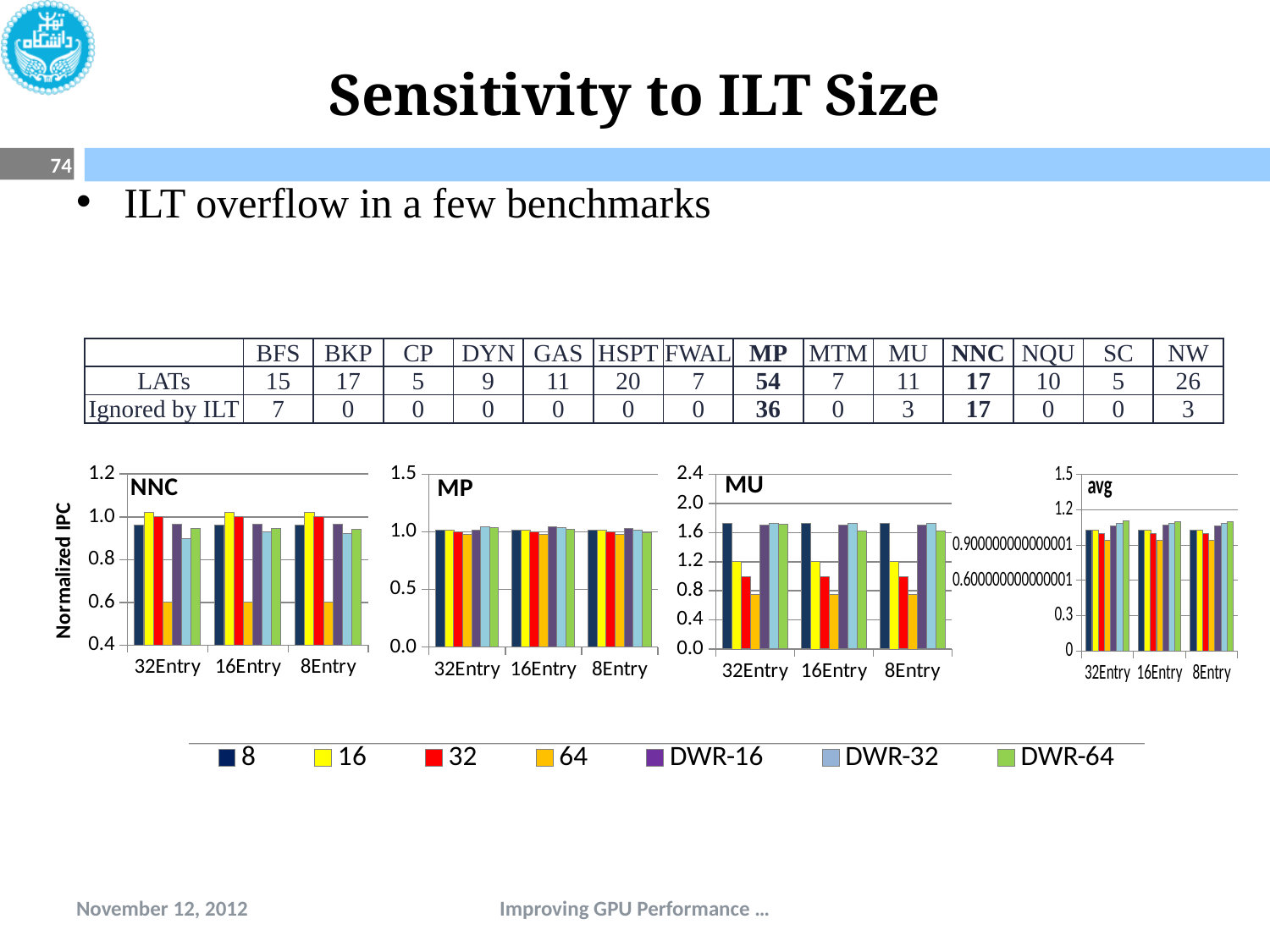
What kind of chart is the NNC chart? bar chart How many categories are shown on the x axis of the MU chart? 3 What is the y-axis label of the NNC chart? Normalized IPC In the MU chart, is the value for the 64 series at 8Entry greater or less than 1.2? less How many series does the shared legend list for the charts? 7 In the NNC chart, is the value for the 64 series at 32Entry greater or less than 0.8? less In the NNC chart at 32Entry, which series has the lowest value? 64 What are the titles of the four charts, from left to right? NNC, MP, MU, avg In the MU chart, is the value for the 8 series at 32Entry greater or less than 1.2? greater In the MU chart at 32Entry, which is larger, the 8 series or the 64 series? 8 In the NNC chart at 8Entry, which is larger, the 16 series or the 64 series? 16